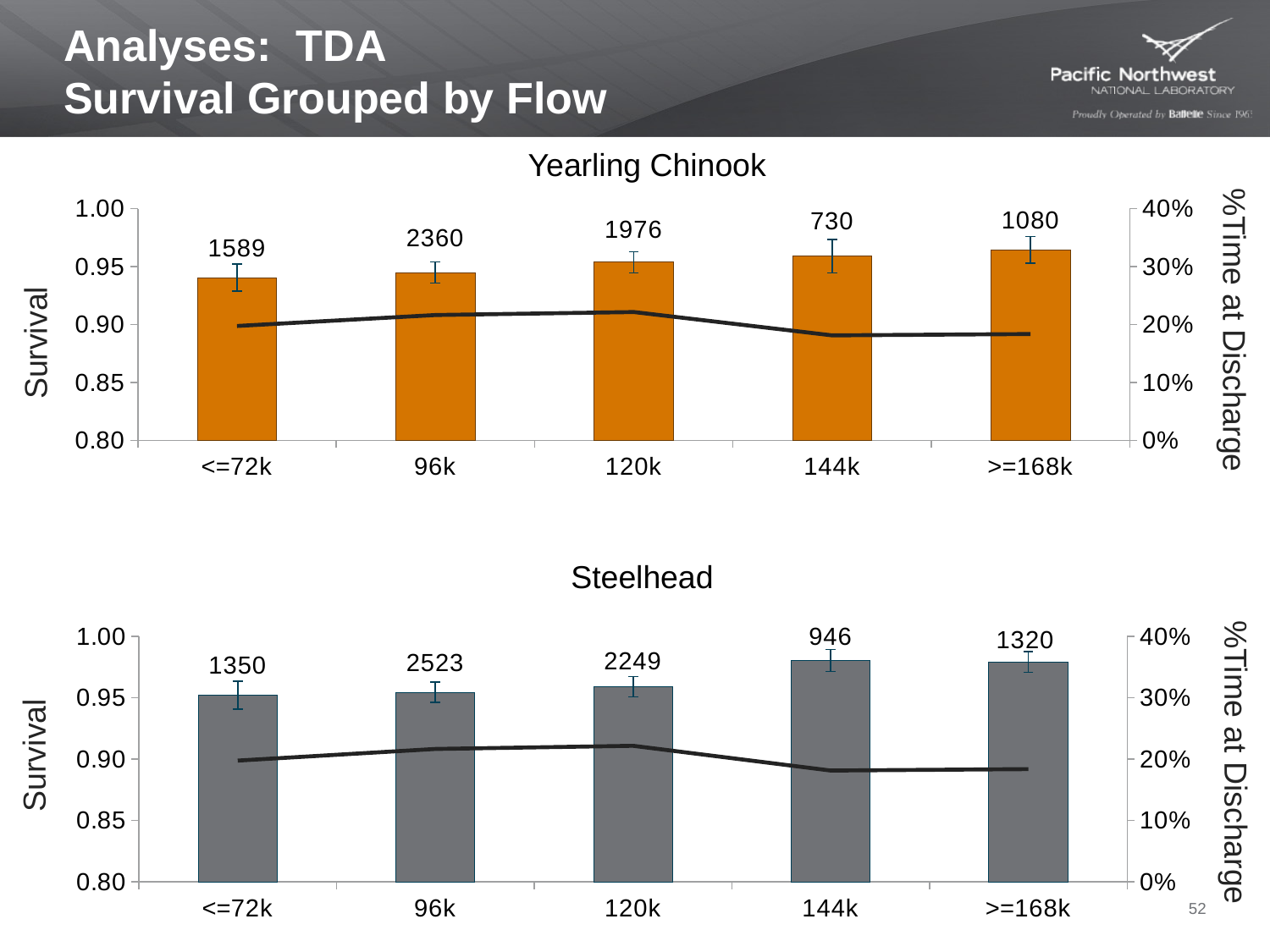
In the Yearling Chinook chart, what number is printed above the bar for 96k? 2360 In the Yearling Chinook chart, which bar is taller, 144k or <=72k? 144k In the Yearling Chinook chart, what is the difference between the numbers printed above the 96k and <=72k bars? 771 In the Steelhead chart, which bar is taller, 144k or <=72k? 144k In the Steelhead chart, is the survival value for 144k greater or less than 0.95? greater In the Yearling Chinook chart, is the survival value for <=72k greater or less than 0.90? greater What is the title of the right-hand vertical axis on the Steelhead chart? %Time at Discharge What kind of chart is the Yearling Chinook chart? Bar chart with a line overlay In the Steelhead chart, what number is printed above the bar for >=168k? 1320 How many flow categories are shown on the x axis of the Steelhead chart? 5 In the Yearling Chinook chart, what number is printed above the bar for 144k? 730 In the Steelhead chart, what number is printed above the bar for <=72k? 1350